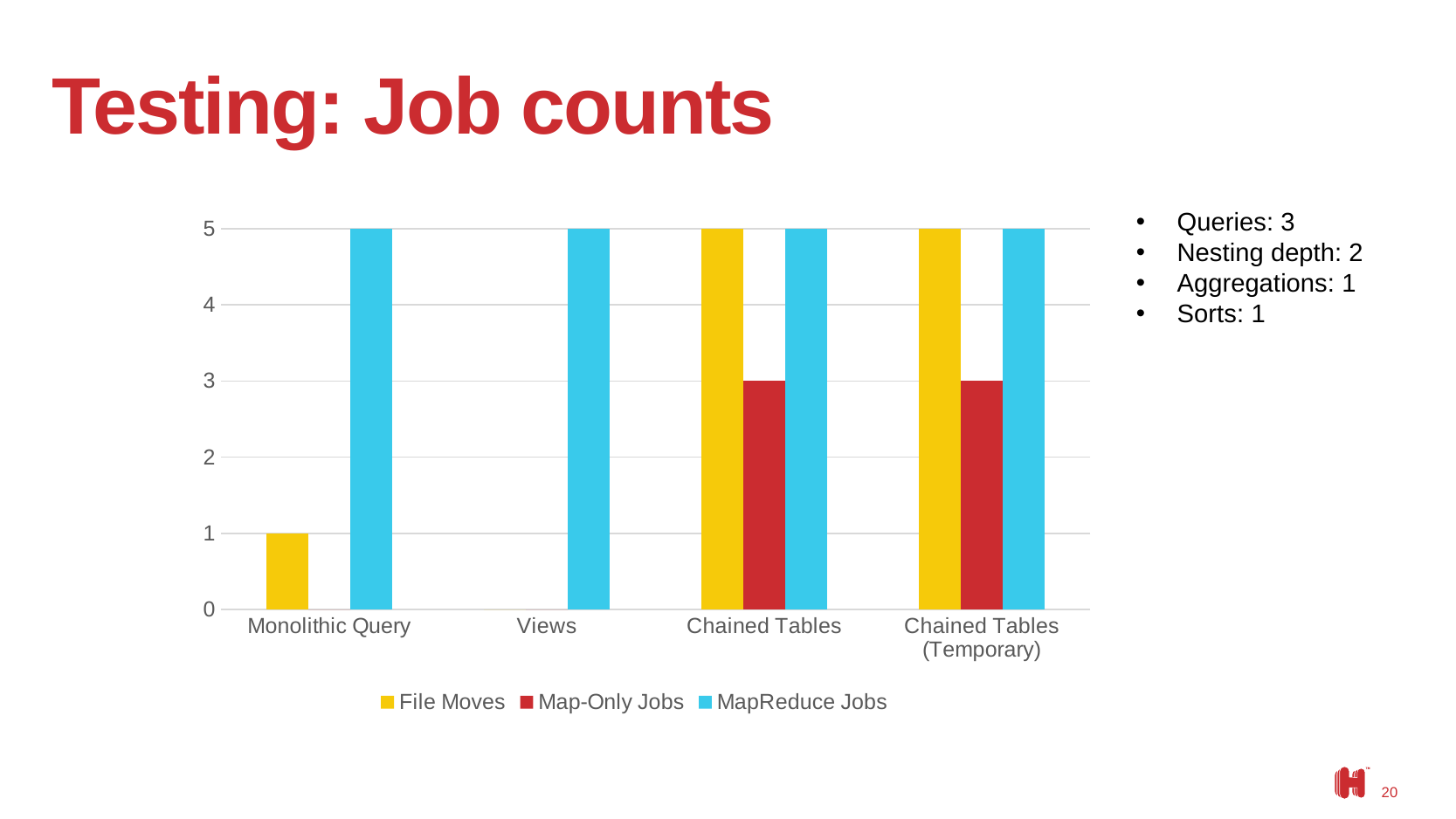
How many categories are shown on the x axis? 4 Is the value of Map-Only Jobs for Chained Tables (Temporary) greater or less than 2? greater What is the value of File Moves for Chained Tables (Temporary)? 5 What is the value of MapReduce Jobs for Views? 5 What is the difference between File Moves for Chained Tables and File Moves for Monolithic Query? 4 What is the value of File Moves for Monolithic Query? 1 What is the value of Map-Only Jobs for Chained Tables? 3 Which series is shown in blue in the legend? MapReduce Jobs What kind of chart is shown on the slide? bar chart Which is larger for Chained Tables: File Moves or Map-Only Jobs? File Moves How many series does the legend list? 3 Which category has the lowest value for File Moves? Views